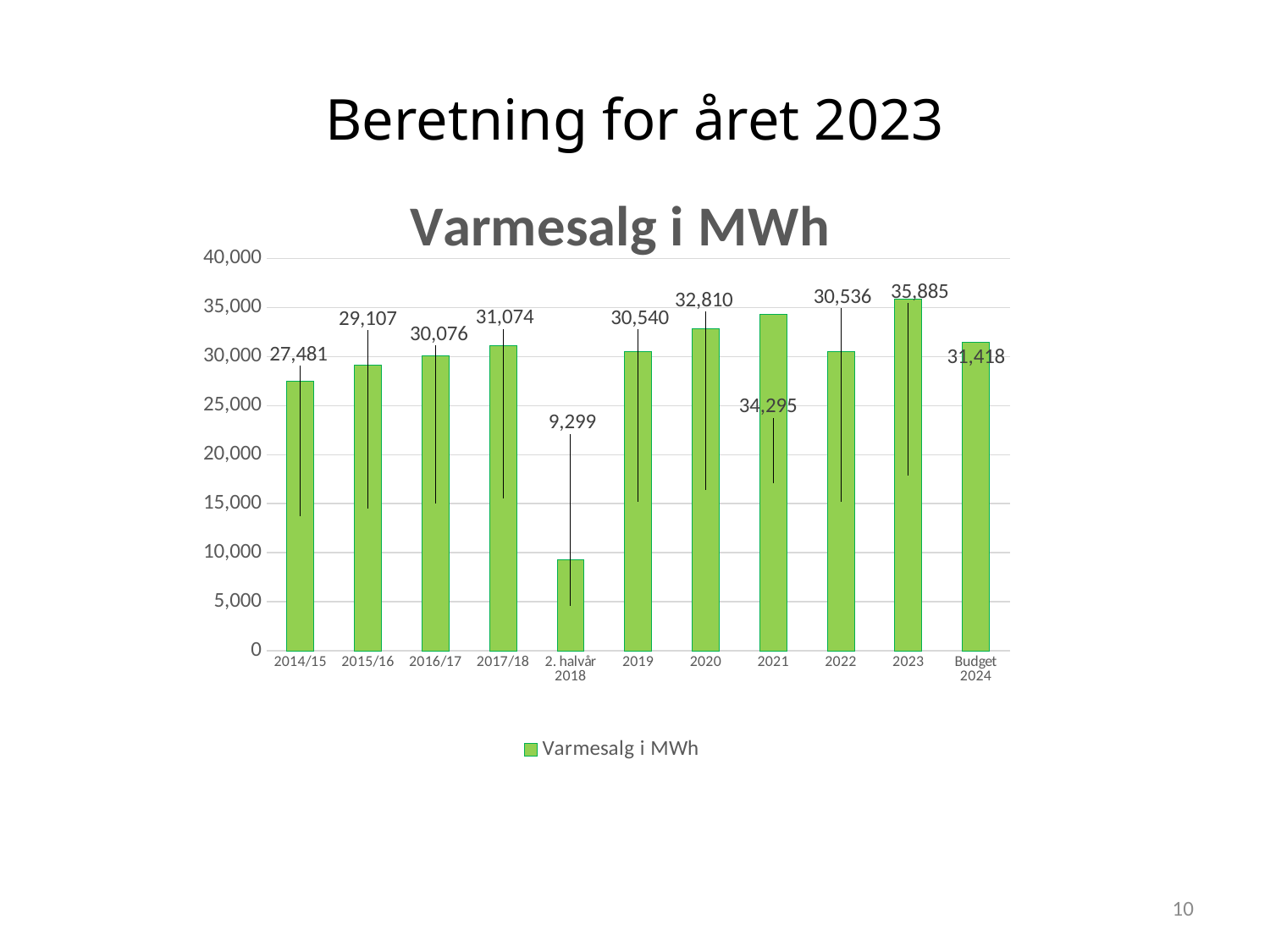
What is the value for 2. halvår 2018? 9,299 Which category has the lowest value? 2. halvår 2018 Which is larger, the value for 2022 or the value for 2019? 2019 How many series does the legend list? 1 What is the title of the chart? Varmesalg i MWh What is the difference between the values for 2021 and 2020? 1,485 What is the value for 2023? 35,885 What is the value for Budget 2024? 31,418 Which category has the highest value? 2023 What is the value for 2014/15? 27,481 What type of chart is shown on the slide? bar chart How many categories are shown on the x axis? 11